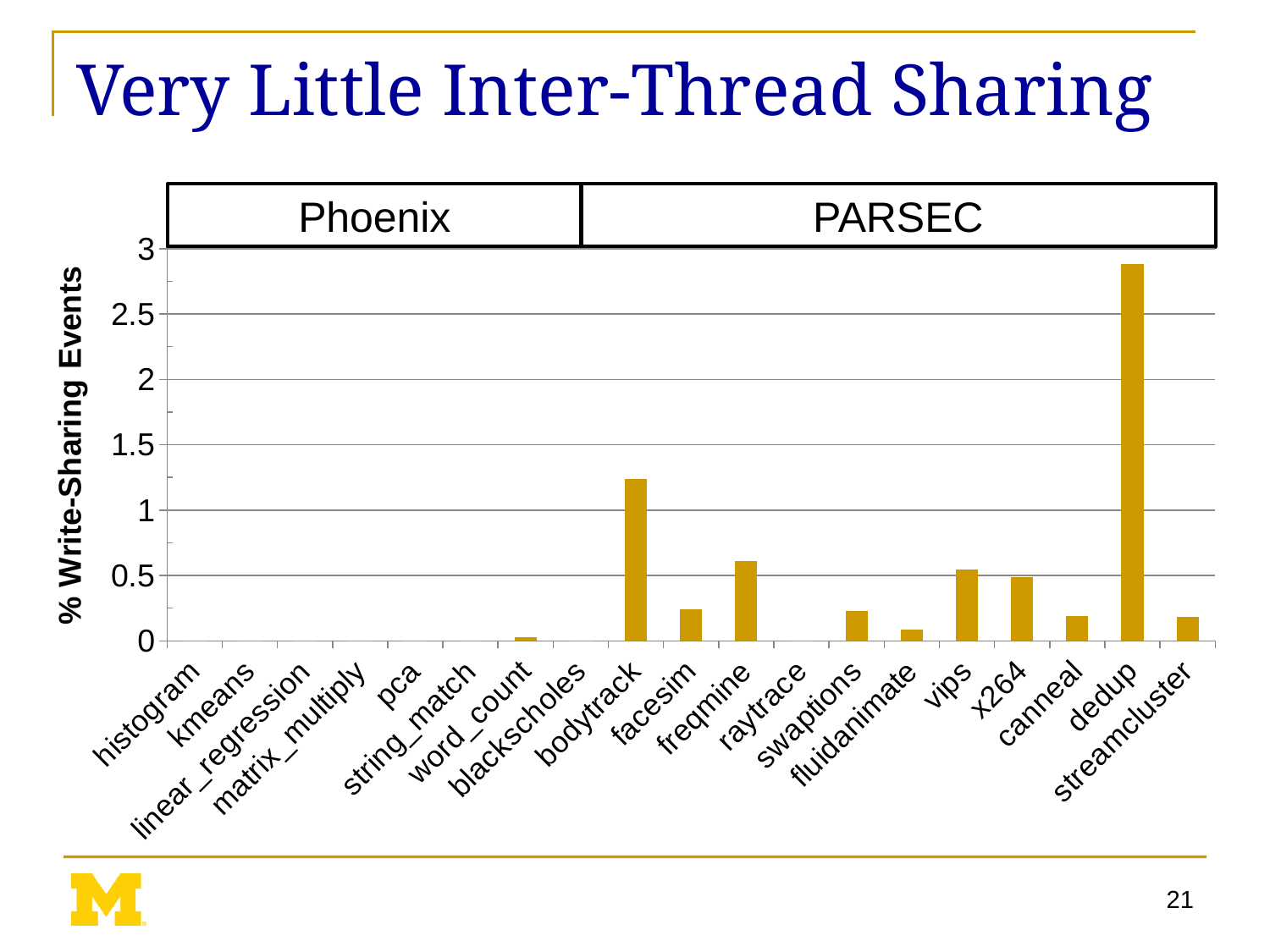
What kind of chart is shown on the slide? bar chart How many benchmarks are listed along the x axis? 19 Is the value for fluidanimate greater or less than 0.5? less Is the value for dedup greater or less than 2.5? greater Which has a higher percentage of write-sharing events, bodytrack or freqmine? bodytrack Is the value for facesim greater or less than 0.5? less Which has a higher percentage of write-sharing events, vips or facesim? vips What are the two benchmark suite groups labelled above the chart? Phoenix and PARSEC Which benchmark has the highest percentage of write-sharing events? dedup What is the label of the y axis? % Write-Sharing Events